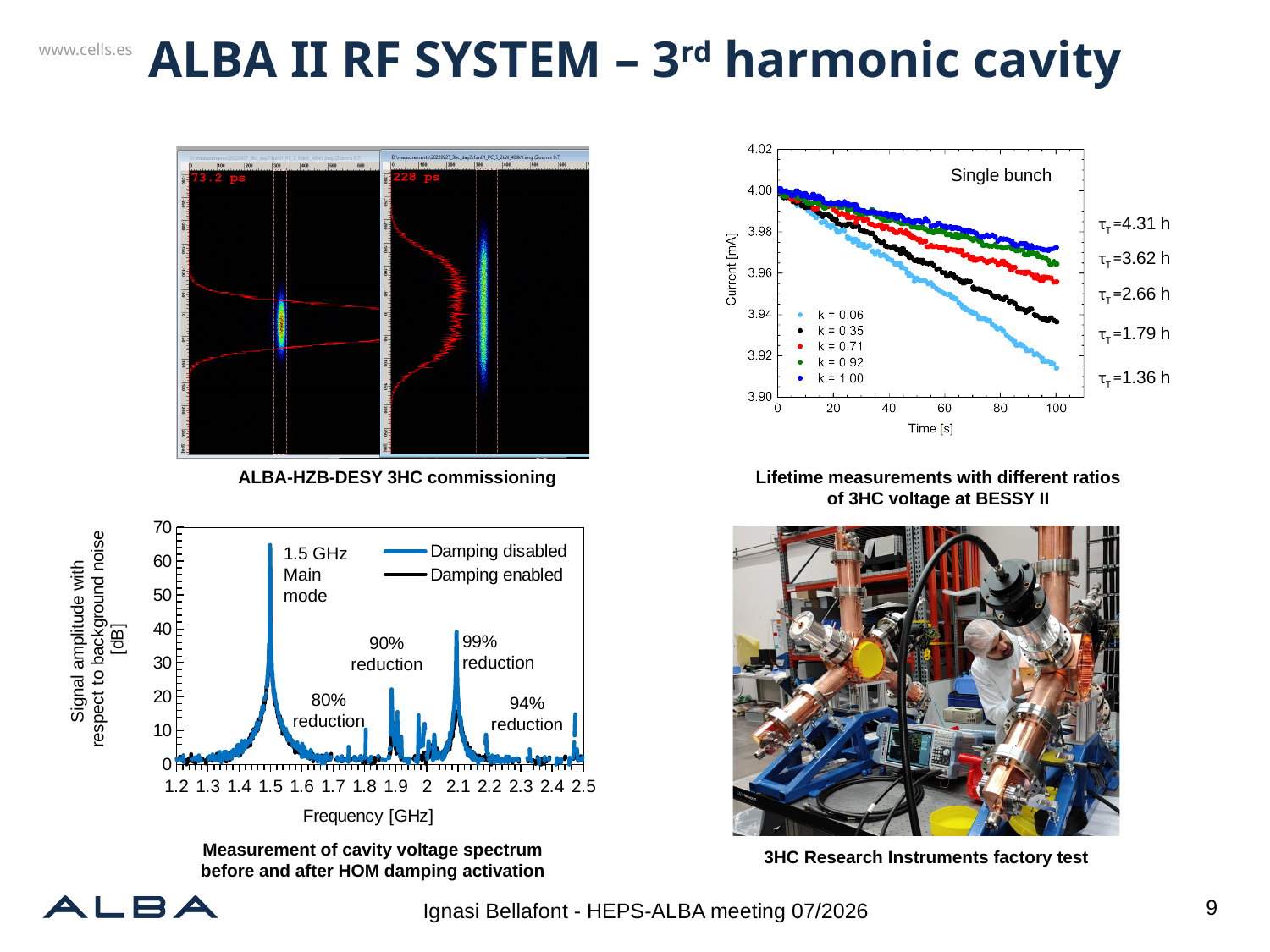
In the lifetime measurements chart (top right), which series shows the highest current at the end of the 100 s time range? k = 1.00 In the lifetime measurements chart (top right), what is the shortest lifetime value annotated next to the curves? 1.36 h In the cavity voltage spectrum chart (bottom left), what kind of chart is it? line chart In the cavity voltage spectrum chart (bottom left), at what frequency is the main mode labelled? 1.5 GHz In the lifetime measurements chart (top right), what is the unit of the y axis? mA In the lifetime measurements chart (top right), what is the longest lifetime value annotated next to the curves? 4.31 h In the cavity voltage spectrum chart (bottom left), is the peak of the main mode at 1.5 GHz greater or less than 60 dB? greater In the lifetime measurements chart (top right), which series shows the lowest current at the end of the 100 s time range? k = 0.06 In the 'Lifetime measurements with different ratios of 3HC voltage at BESSY II' chart, how many series does the legend list? 5 In the cavity voltage spectrum chart (bottom left), what reduction percentage is labelled for the peak near 2.1 GHz? 99% reduction In the 'Measurement of cavity voltage spectrum before and after HOM damping activation' chart, how many series does the legend list? 2 In the lifetime measurements chart (top right), do the current values rise or fall as time increases? fall